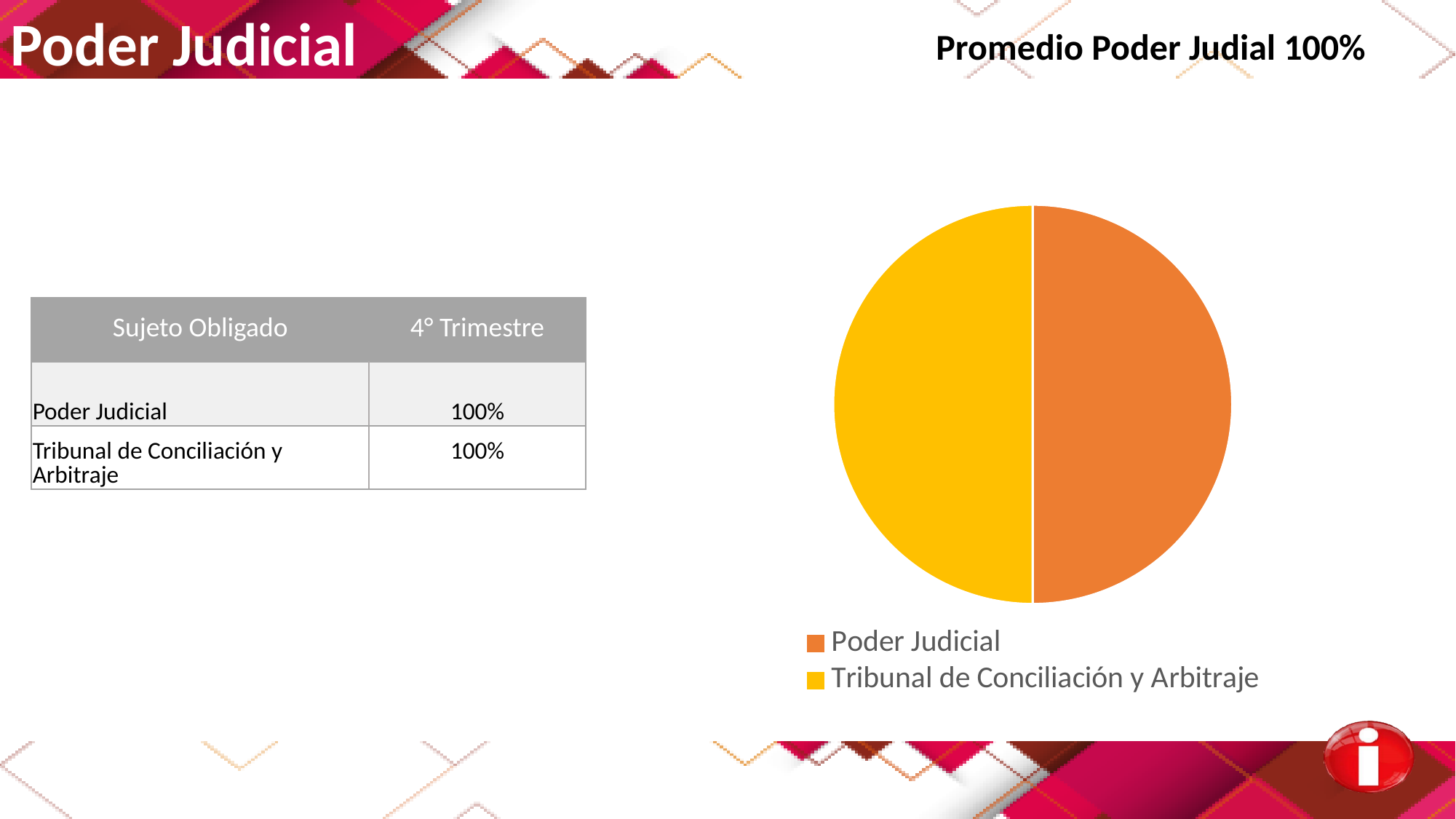
What is the difference between the values for Poder Judicial and Tribunal de Conciliación y Arbitraje? 0% What is the value for Tribunal de Conciliación y Arbitraje in the 4° Trimestre? 100% Which is larger, the value for Poder Judicial or the value for Tribunal de Conciliación y Arbitraje? They are equal What is the value for Poder Judicial in the 4° Trimestre? 100% What share of the pie does the Tribunal de Conciliación y Arbitraje slice take? 50% What share of the pie does the Poder Judicial slice take? 50% Which colour represents Tribunal de Conciliación y Arbitraje in the pie chart? Yellow What kind of chart is shown on the slide? Pie chart How many entries does the pie chart's legend list? 2 How many slices does the pie chart have? 2 Which colour represents Poder Judicial in the pie chart? Orange